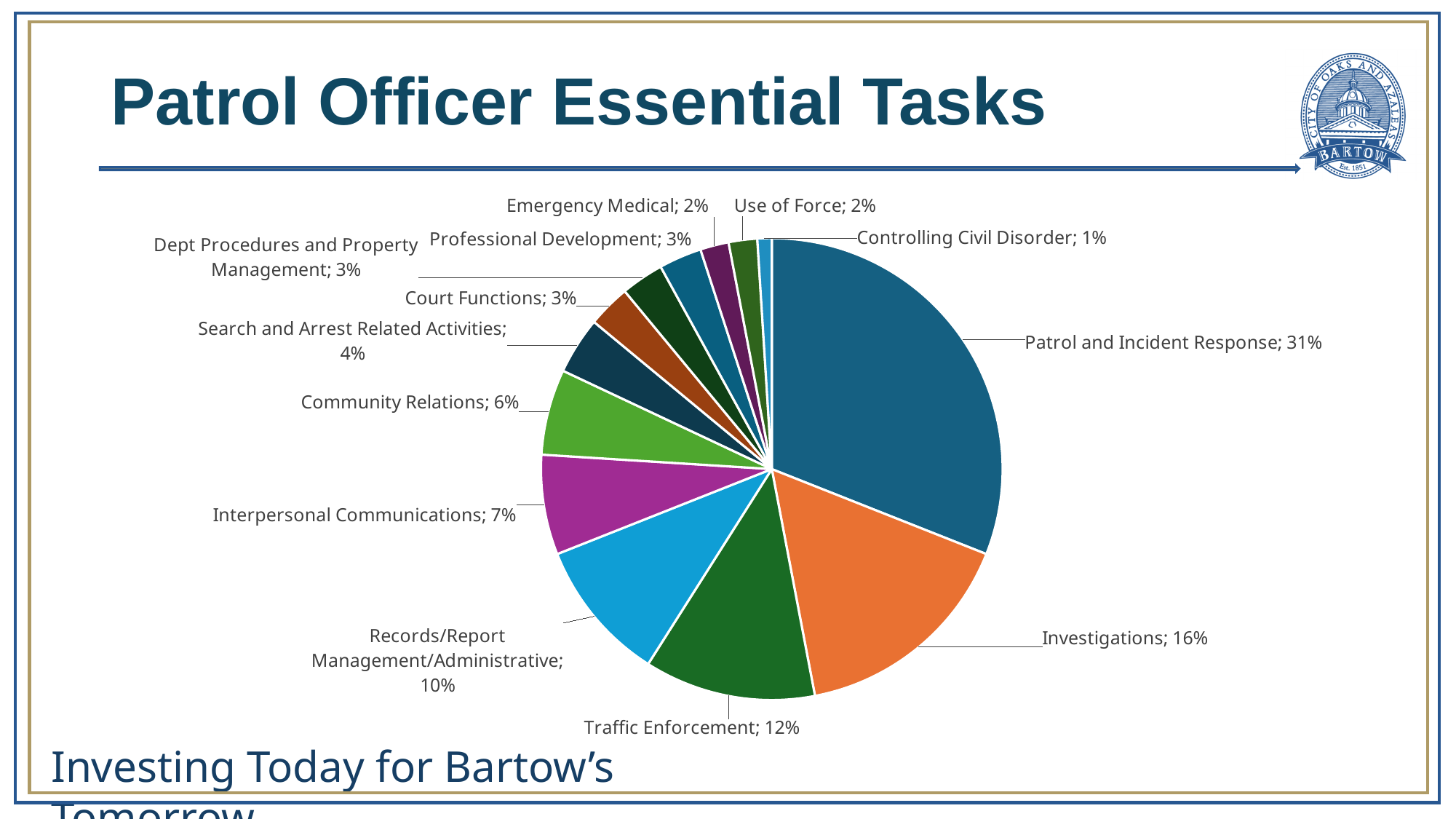
What share is labelled for Search and Arrest Related Activities? 4% What kind of chart is shown on the slide? Pie chart What percentage is shown for Records/Report Management/Administrative? 10% What is the difference in percentage points between Patrol and Incident Response and Investigations? 15 What is the title of the slide containing the chart? Patrol Officer Essential Tasks Which task has the smallest slice of the pie? Controlling Civil Disorder How many slices does the pie chart have? 13 Which task has the largest slice of the pie? Patrol and Incident Response What share of the pie is Patrol and Incident Response? 31% What value is labelled for Traffic Enforcement? 12% What percentage is shown for Investigations? 16% Which is larger, Interpersonal Communications or Community Relations? Interpersonal Communications